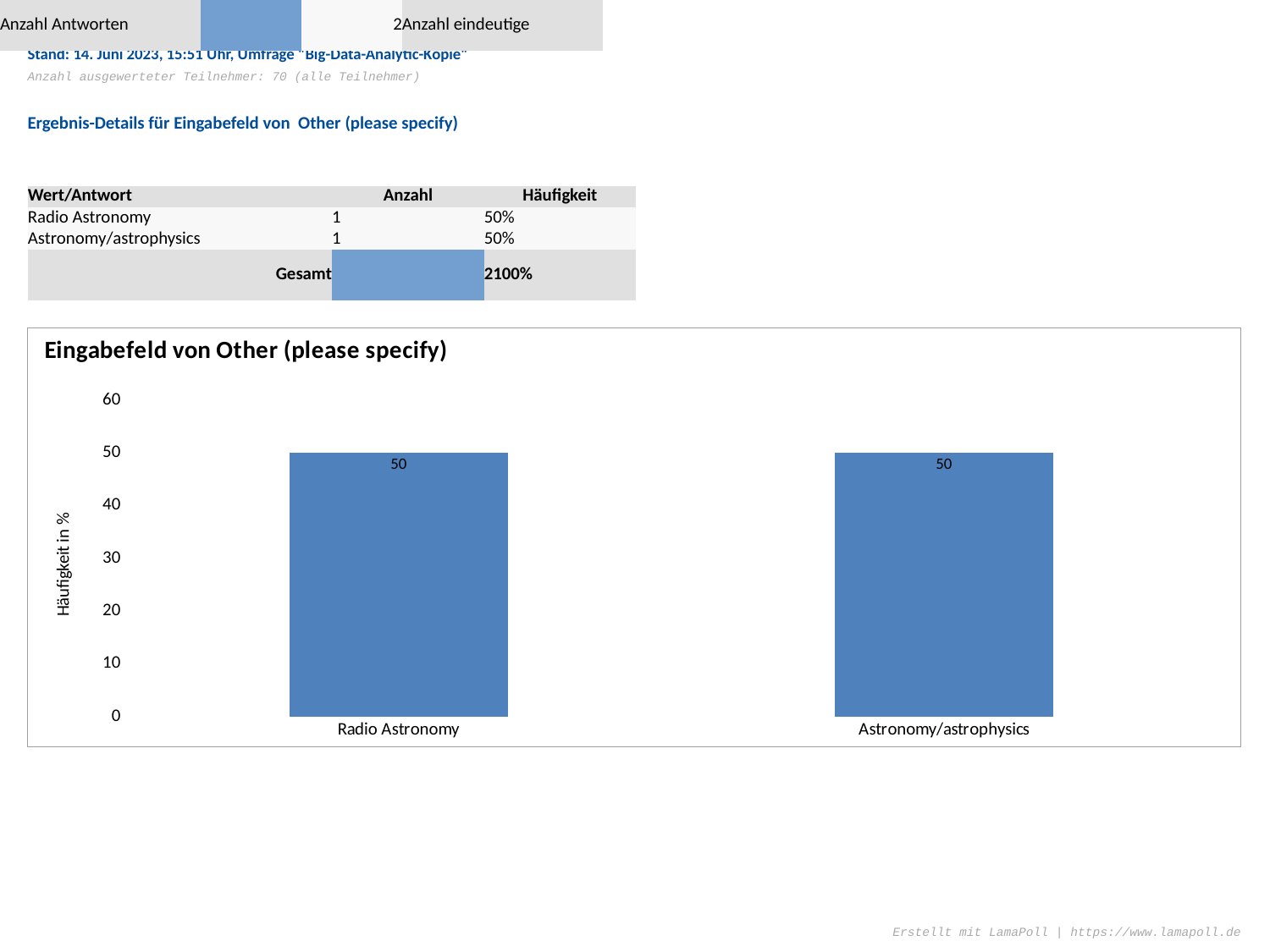
What is the label of the y axis of the chart? Häufigkeit in % What is the value for Radio Astronomy in the chart? 50 What is the value for Astronomy/astrophysics in the chart? 50 What is the difference between the values for Radio Astronomy and Astronomy/astrophysics? 0 Is the value for Astronomy/astrophysics greater or less than 60? less What is the title of the chart? Eingabefeld von Other (please specify) Is the value for Radio Astronomy greater or less than 40? greater What is the total of the values for Radio Astronomy and Astronomy/astrophysics in the chart? 100 How many categories are shown on the x axis of the chart? 2 What kind of chart is shown on the slide? bar chart